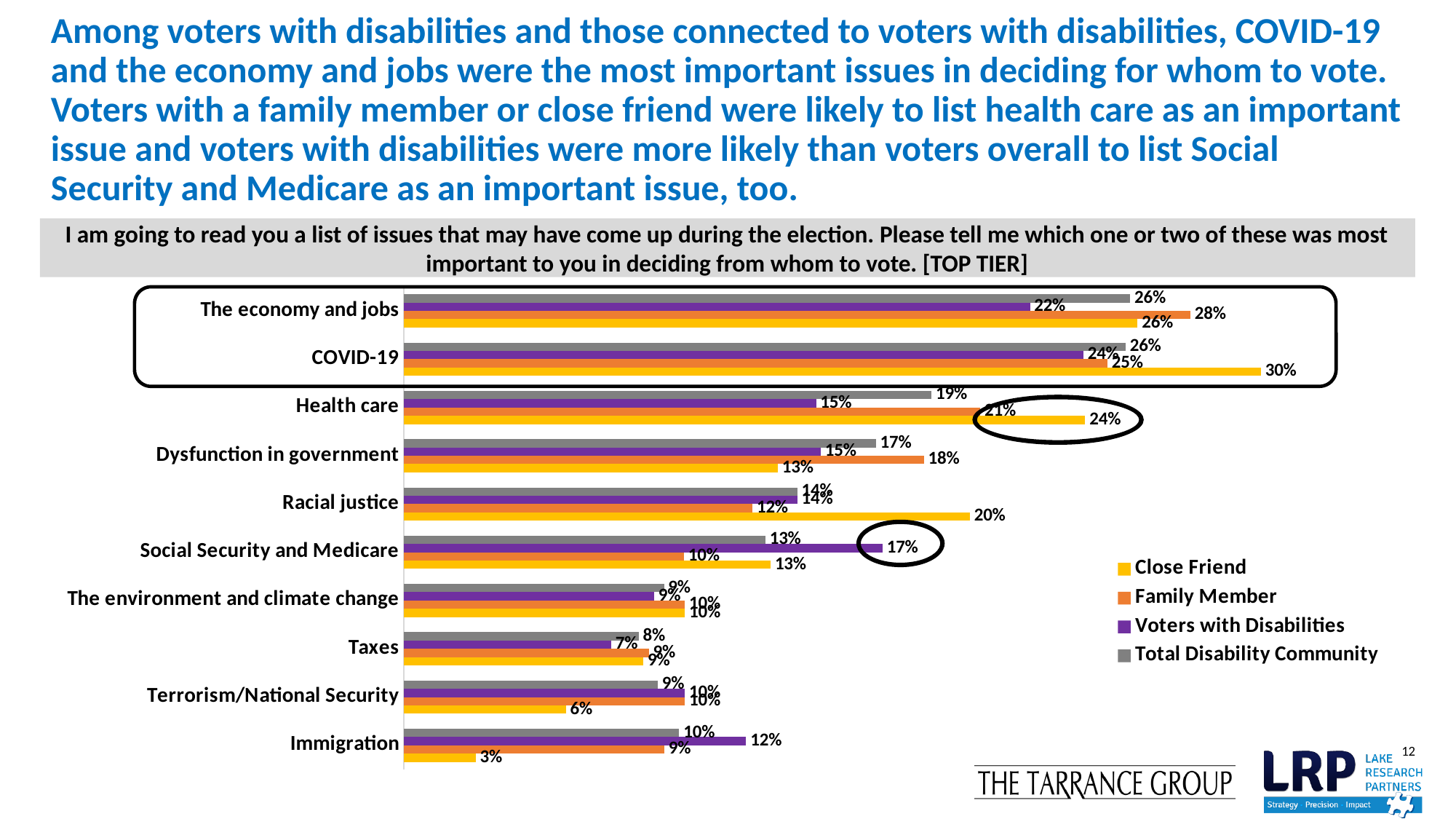
What is the Voters with Disabilities value for Social Security and Medicare? 17% What percentage of Close Friend respondents listed COVID-19 as a most important issue? 30% What is the Family Member value for The economy and jobs? 28% For Immigration, which is larger: the Voters with Disabilities value or the Close Friend value? Voters with Disabilities What is the Total Disability Community value for Health care? 19% How many issues are listed on the chart? 10 Which issue has the highest Close Friend value? COVID-19 Which issue has the lowest Close Friend value? Immigration Which colour represents the Family Member series in the legend? Orange What kind of chart is shown on the slide? Bar chart How many series does the legend list? 4 What is the difference between the Close Friend and Voters with Disabilities values for Racial justice? 6%